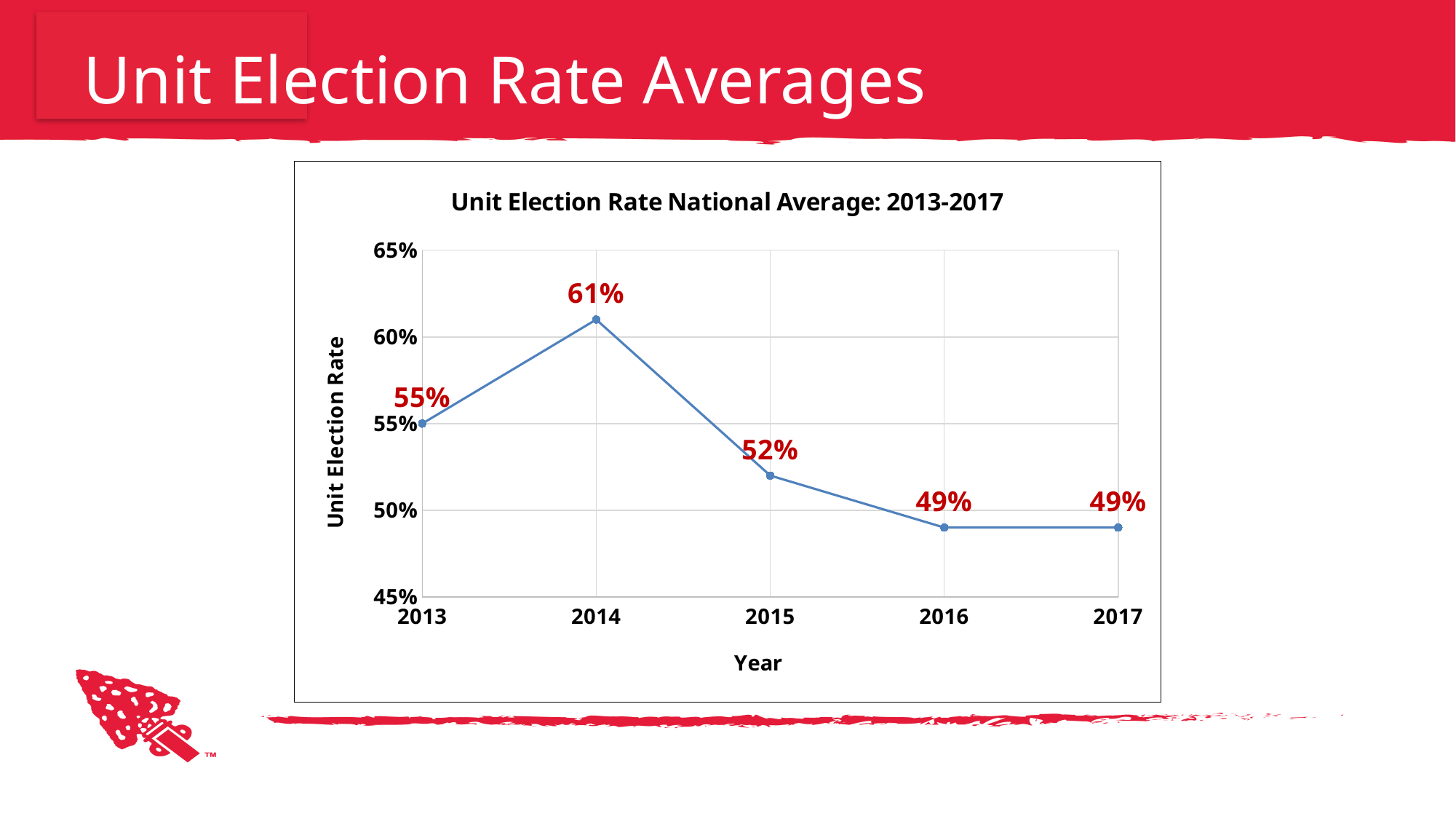
How many years are plotted on the chart? 5 What is the unit election rate for 2015? 52% Is the unit election rate for 2016 greater or less than 50%? less Which year has the highest unit election rate? 2014 What is the difference between the unit election rate in 2014 and in 2015? 9% What is the unit election rate for 2013? 55% Which is larger, the unit election rate in 2013 or in 2015? 2013 What is the unit election rate for 2017? 49% What is the title of the chart? Unit Election Rate National Average: 2013-2017 What is the difference between the unit election rate in 2013 and in 2016? 6% What is the unit election rate for 2014? 61% What kind of chart is shown on the slide? line chart